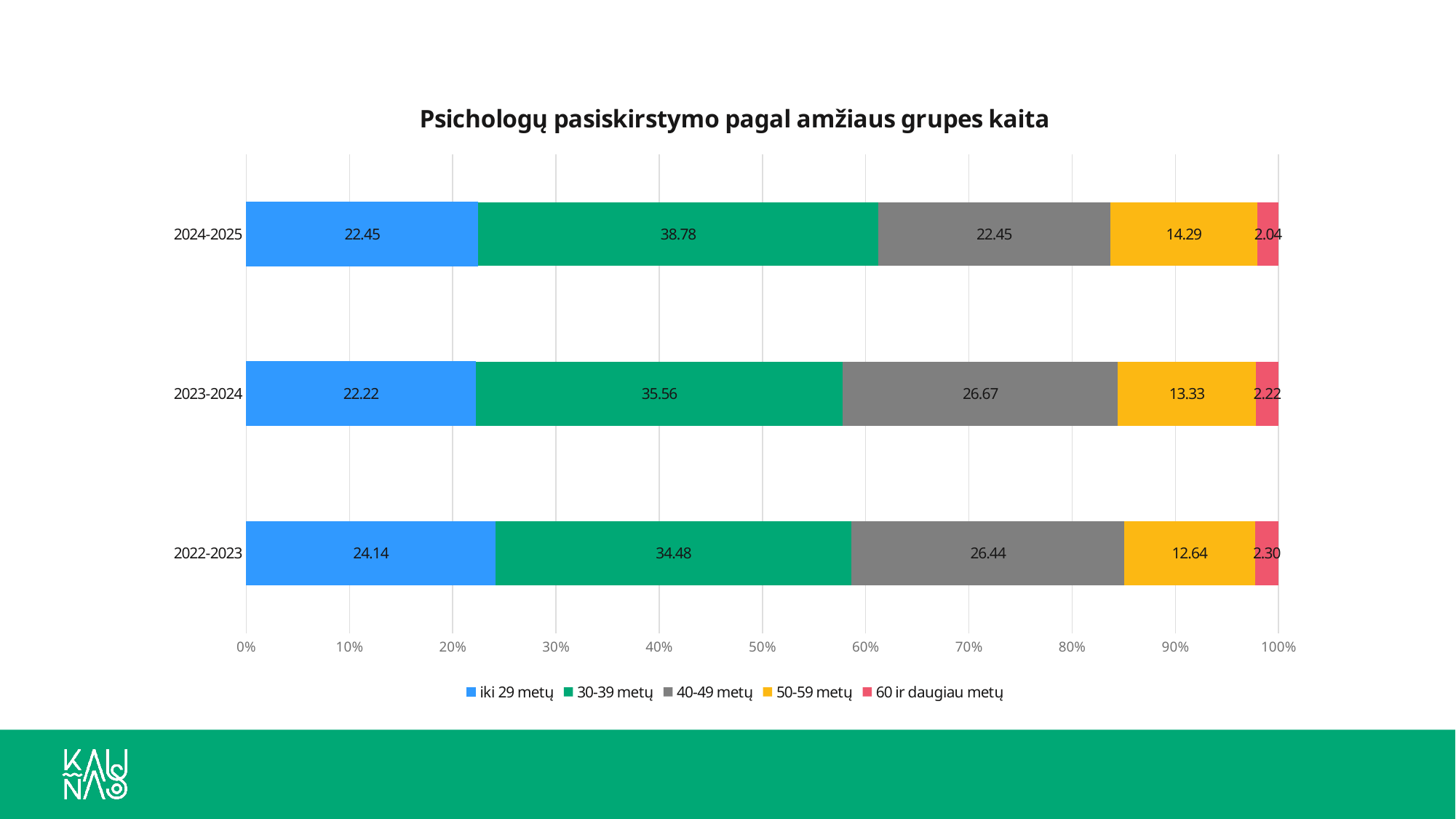
How many series does the legend list? 5 What is the difference between the 30-39 metų values for 2024-2025 and 2023-2024? 3.22 Which is larger: the 50-59 metų value for 2024-2025 or for 2022-2023? 2024-2025 Which year has the highest value for 30-39 metų? 2024-2025 What kind of chart is shown on the slide? Stacked bar chart Which age group has the largest share in the 2022-2023 bar? 30-39 metų Which year has the lowest value for 60 ir daugiau metų? 2024-2025 What is the value for iki 29 metų in 2022-2023? 24.14 What is the value for 30-39 metų in 2024-2025? 38.78 Does the 30-39 metų share rise or fall from 2022-2023 to 2024-2025? Rise How many years (bars) are shown in the chart? 3 What is the value for 40-49 metų in 2023-2024? 26.67